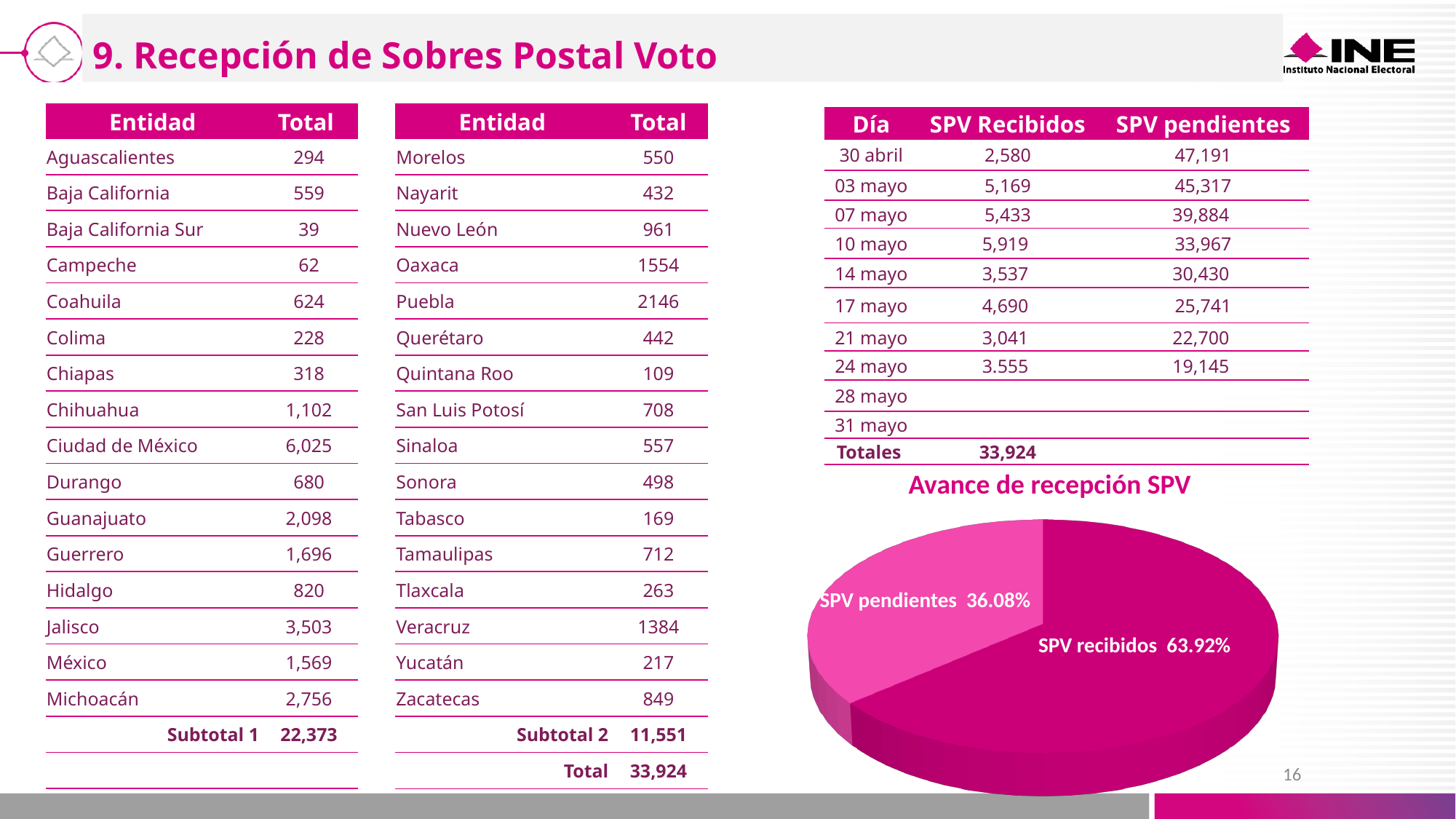
In the pie chart, what is the difference in percentage points between SPV recibidos and SPV pendientes? 27.84 Is the share for SPV recibidos in the pie chart greater or less than 50%? greater Is the share for SPV pendientes in the pie chart greater or less than 50%? less Which slice of the pie chart is the smallest? SPV pendientes What is the title of the pie chart on the slide? Avance de recepción SPV Which slice of the pie chart is the largest? SPV recibidos How many slices does the pie chart have? 2 In the pie chart, which slice is shown in the lighter pink colour? SPV pendientes In the pie chart, what share is labelled for SPV pendientes? 36.08% In the pie chart, which is larger: SPV recibidos or SPV pendientes? SPV recibidos What kind of chart is shown under the title "Avance de recepción SPV"? pie chart In the pie chart, what share is labelled for SPV recibidos? 63.92%